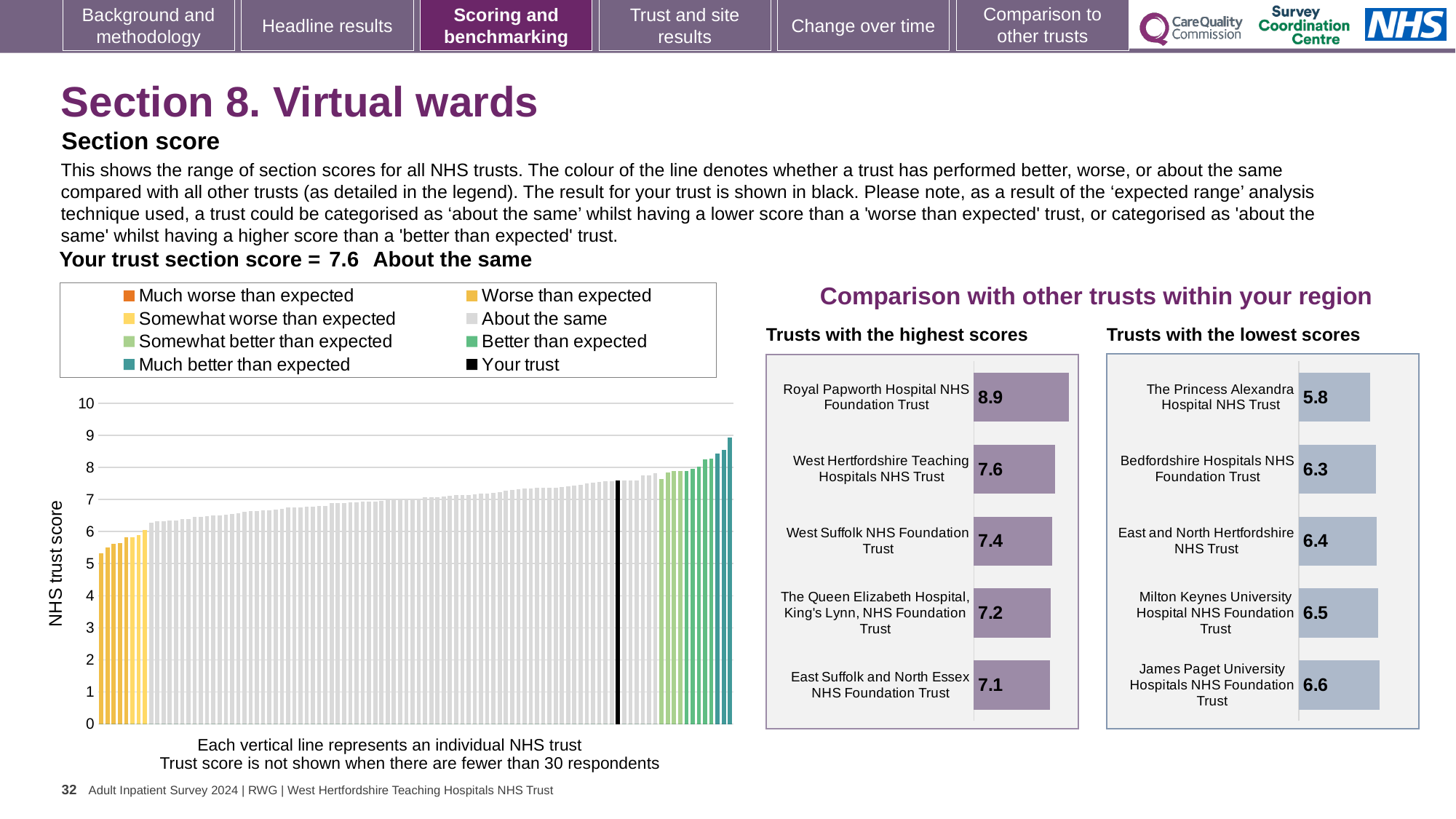
In the 'Trusts with the lowest scores' chart, what is the score for Milton Keynes University Hospital NHS Foundation Trust? 6.5 In the 'Trusts with the lowest scores' chart, what is the score for The Princess Alexandra Hospital NHS Trust? 5.8 In the 'Trusts with the highest scores' chart, what is the difference between the scores of Royal Papworth Hospital NHS Foundation Trust and West Hertfordshire Teaching Hospitals NHS Trust? 1.3 In the NHS trust score chart on the left, do the values rise or fall from left to right? Rise How many entries does the legend of the NHS trust score chart on the left list? 8 In the 'Trusts with the highest scores' chart, what is the score for Royal Papworth Hospital NHS Foundation Trust? 8.9 In the 'Trusts with the lowest scores' chart, which trust has the lowest score? The Princess Alexandra Hospital NHS Trust How many trusts are shown in the 'Trusts with the highest scores' chart? 5 In the 'Trusts with the lowest scores' chart, how much higher is the score of James Paget University Hospitals NHS Foundation Trust than that of The Princess Alexandra Hospital NHS Trust? 0.8 In the 'Trusts with the highest scores' chart, which has the larger score: West Suffolk NHS Foundation Trust or The Queen Elizabeth Hospital, King's Lynn, NHS Foundation Trust? West Suffolk NHS Foundation Trust What kind of chart is the NHS trust score chart on the left of the slide? Bar chart In the 'Trusts with the highest scores' chart, which trust has the highest score? Royal Papworth Hospital NHS Foundation Trust